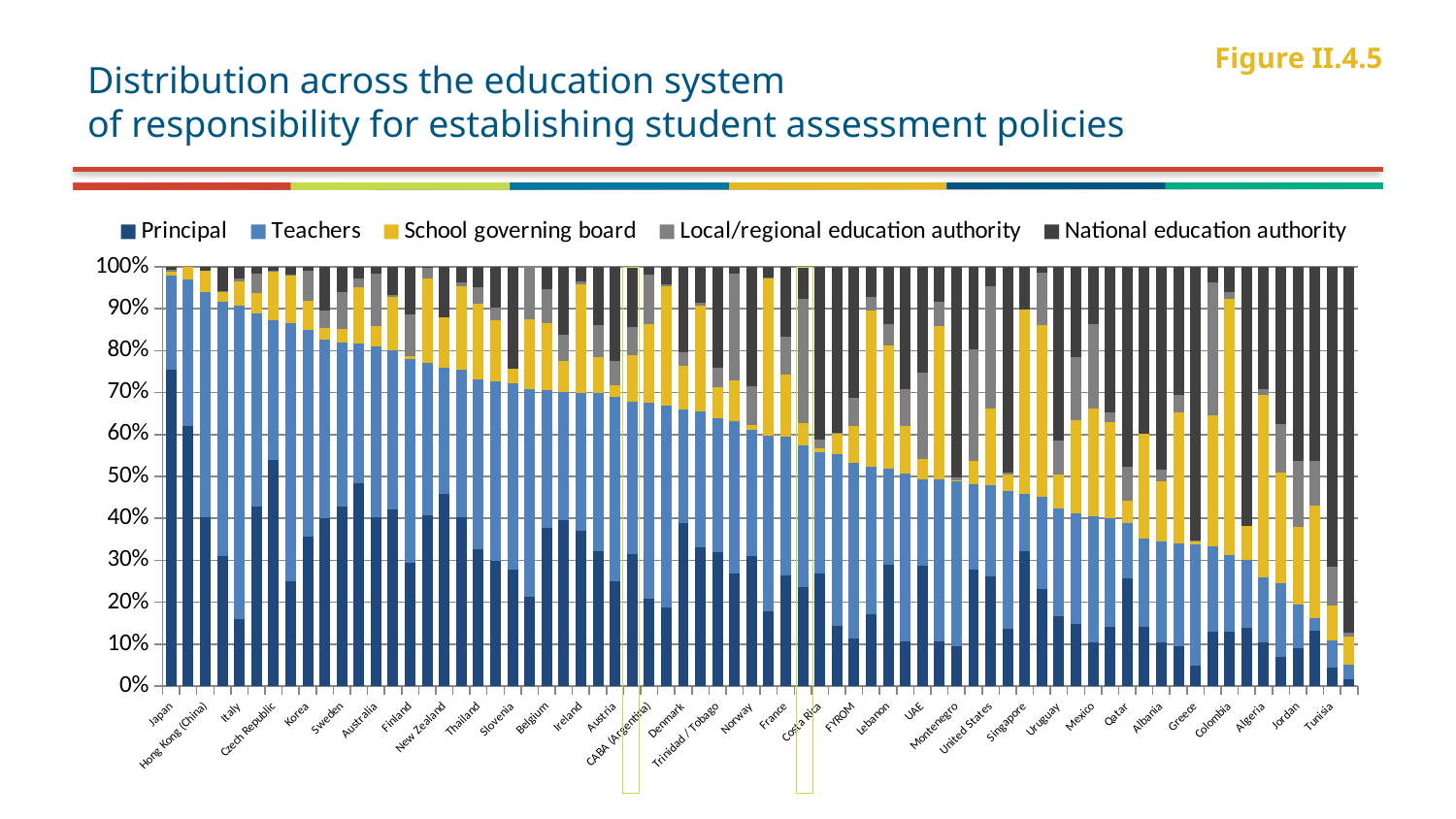
Which country has the larger Principal share, Japan or Tunisia? Japan Is the Principal share for Japan greater or less than 70%? greater Which series is shown in yellow in the legend? School governing board How many series does the legend list? 5 Does the combined Principal and Teachers share rise or fall moving from left to right across the countries? fall What kind of chart is shown on the slide? Stacked bar chart Is the combined Principal and Teachers share for Japan greater or less than 90%? greater Is the Principal share for Tunisia greater or less than 10%? less Which country is listed first on the left of the x axis? Japan Does the National education authority share rise or fall moving from left to right across the countries? rise What is the title of the chart on the slide? Distribution across the education system of responsibility for establishing student assessment policies